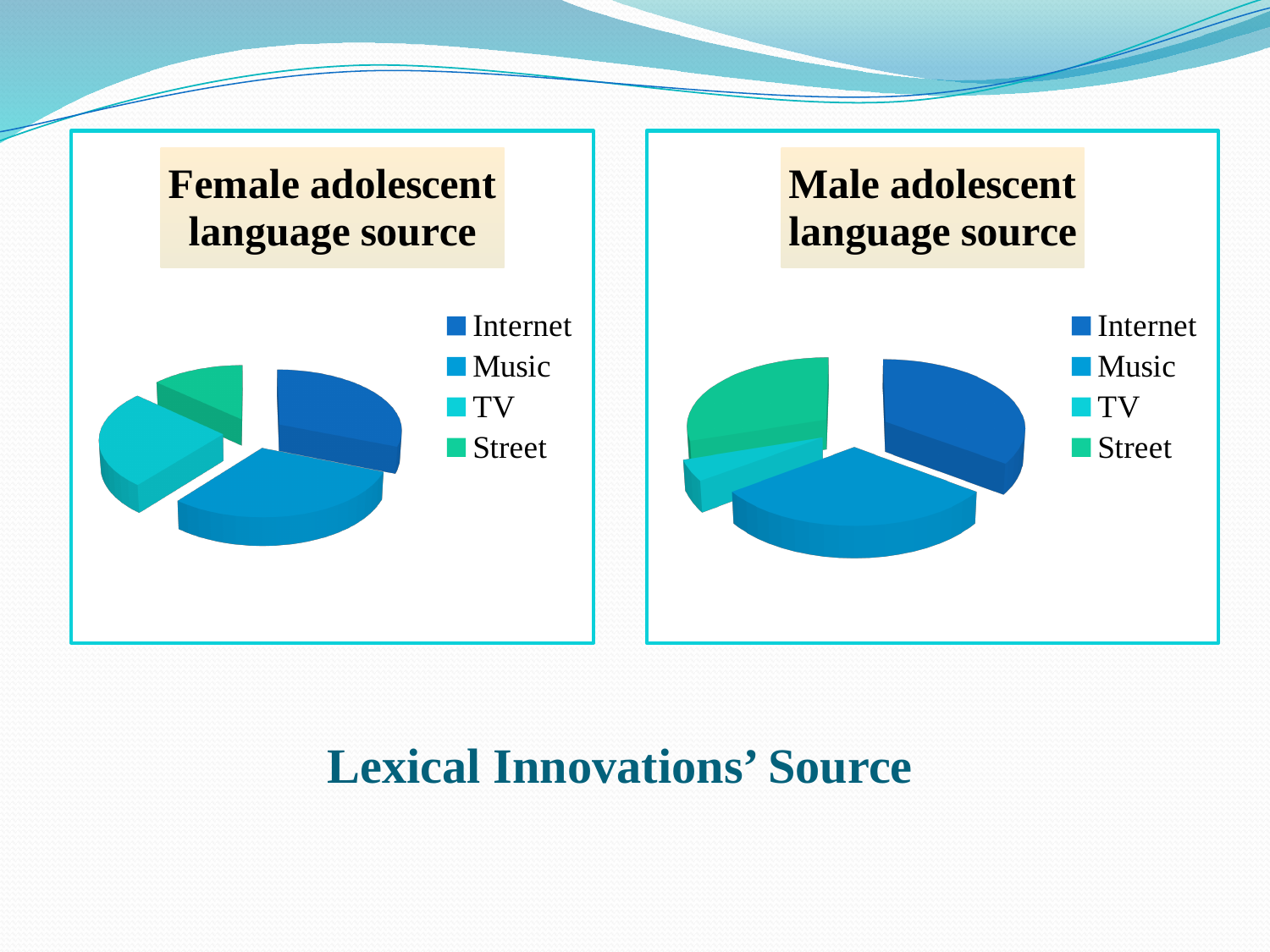
What kind of chart is the "Male adolescent language source" chart? pie chart In the "Female adolescent language source" chart, which category has the smallest slice? Street What kind of chart is the "Female adolescent language source" chart? pie chart How many categories does the legend of the "Male adolescent language source" chart list? 4 In the "Male adolescent language source" chart, which slice is larger, Street or TV? Street In the "Male adolescent language source" chart, which category has the largest slice? Internet What are the legend entries of the "Female adolescent language source" chart, in order? Internet, Music, TV, Street How many slices does the "Female adolescent language source" pie chart have? 4 In the "Male adolescent language source" chart, which category has the smallest slice? TV What is the title of the chart on the right side of the slide? Male adolescent language source In the "Female adolescent language source" chart, which slice is larger, Internet or Street? Internet